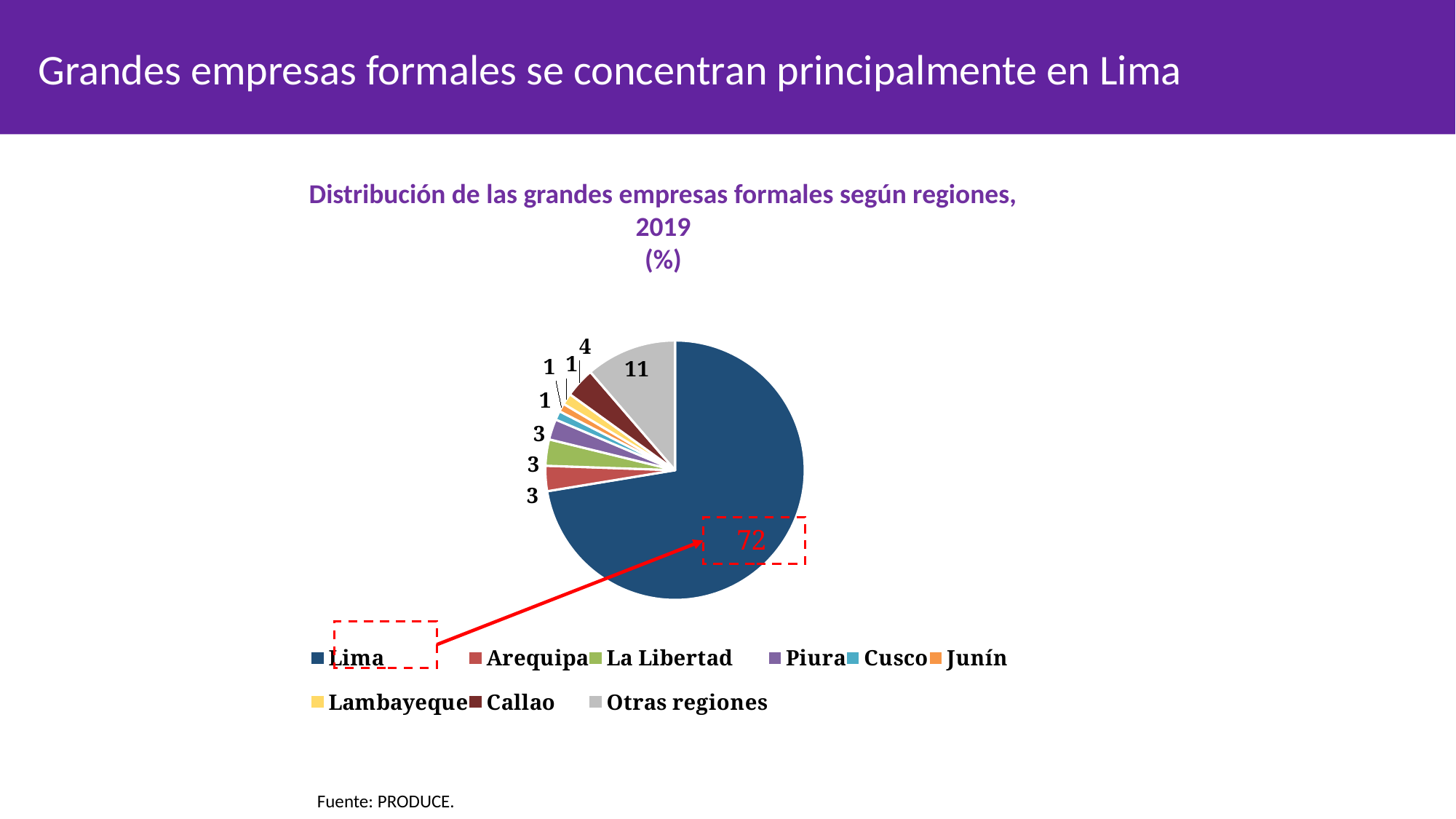
What is the difference between the values for Callao and Piura? 1 What is the title of the chart? Distribución de las grandes empresas formales según regiones, 2019 (%) What type of chart is shown on the slide? Pie chart How many regions (slices) are shown in the pie chart? 9 What value is shown for Cusco in the pie chart? 1 Which has a larger value, Callao or La Libertad? Callao What value is shown for Arequipa in the pie chart? 3 Which region has the largest slice of the pie chart? Lima What value is shown for Otras regiones in the pie chart? 11 What percentage of large formal companies is in Lima according to the pie chart? 72 What value is shown for Callao in the pie chart? 4 What is the difference between the values for Lima and Otras regiones? 61